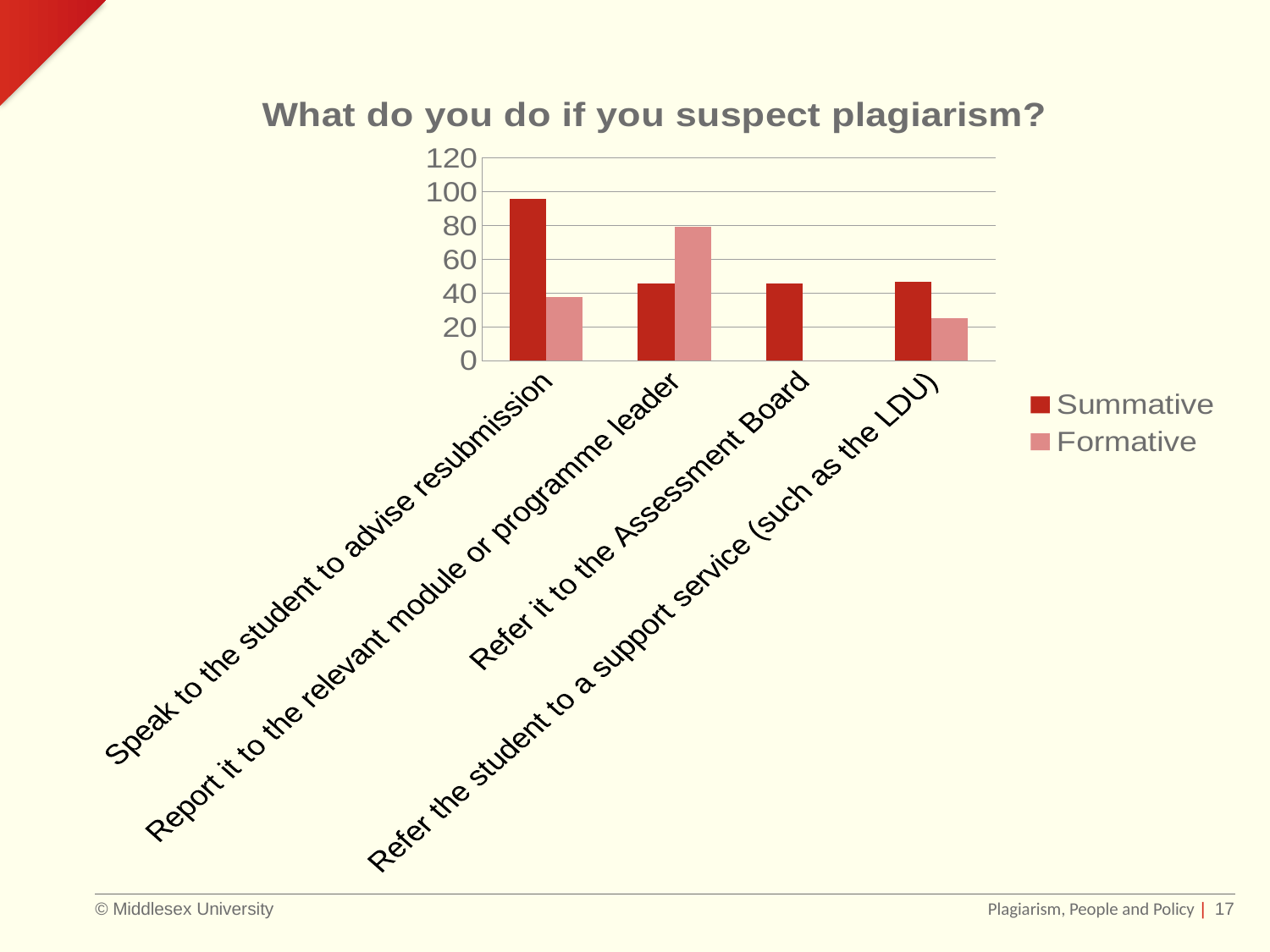
What is the title of the chart? What do you do if you suspect plagiarism? How many series does the legend list? 2 For 'Speak to the student to advise resubmission', which series has the larger value, Summative or Formative? Summative Which category has the lowest Formative value? Refer it to the Assessment Board Is the Summative value for 'Speak to the student to advise resubmission' greater or less than 80? greater Is the Formative value for 'Report it to the relevant module or programme leader' greater or less than 60? greater Which category has the highest Summative value? Speak to the student to advise resubmission How many categories are shown on the x axis? 4 What kind of chart is shown on the slide? bar chart For 'Report it to the relevant module or programme leader', which series has the larger value, Summative or Formative? Formative Is the Formative value for 'Refer the student to a support service (such as the LDU)' greater or less than 40? less Which category has the highest Formative value? Report it to the relevant module or programme leader